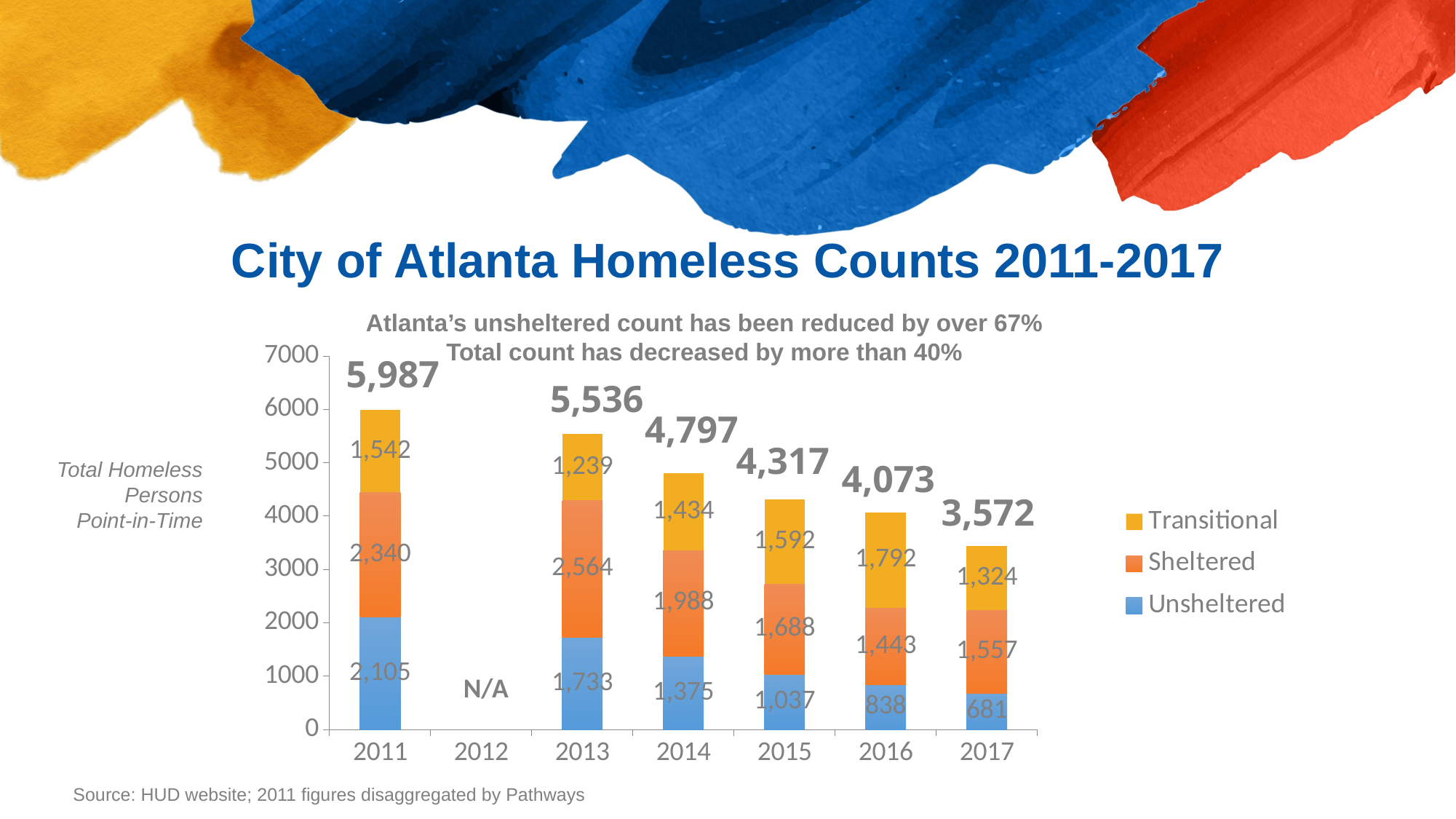
What is the total homeless count shown for 2014? 4,797 In 2015, which is larger: the Sheltered count or the Transitional count? Sheltered How many series does the legend list? 3 Which year on the x axis is marked N/A with no bar? 2012 What kind of chart is shown on the slide? Stacked bar chart What is the Unsheltered count for 2011? 2,105 Do the total homeless counts rise or fall from 2011 to 2017? Fall Which year has the highest total homeless count? 2011 Which year has the lowest Unsheltered count? 2017 What is the difference between the Unsheltered count in 2011 and in 2017? 1,424 What is the Sheltered count for 2013? 2,564 What is the Transitional count for 2016? 1,792